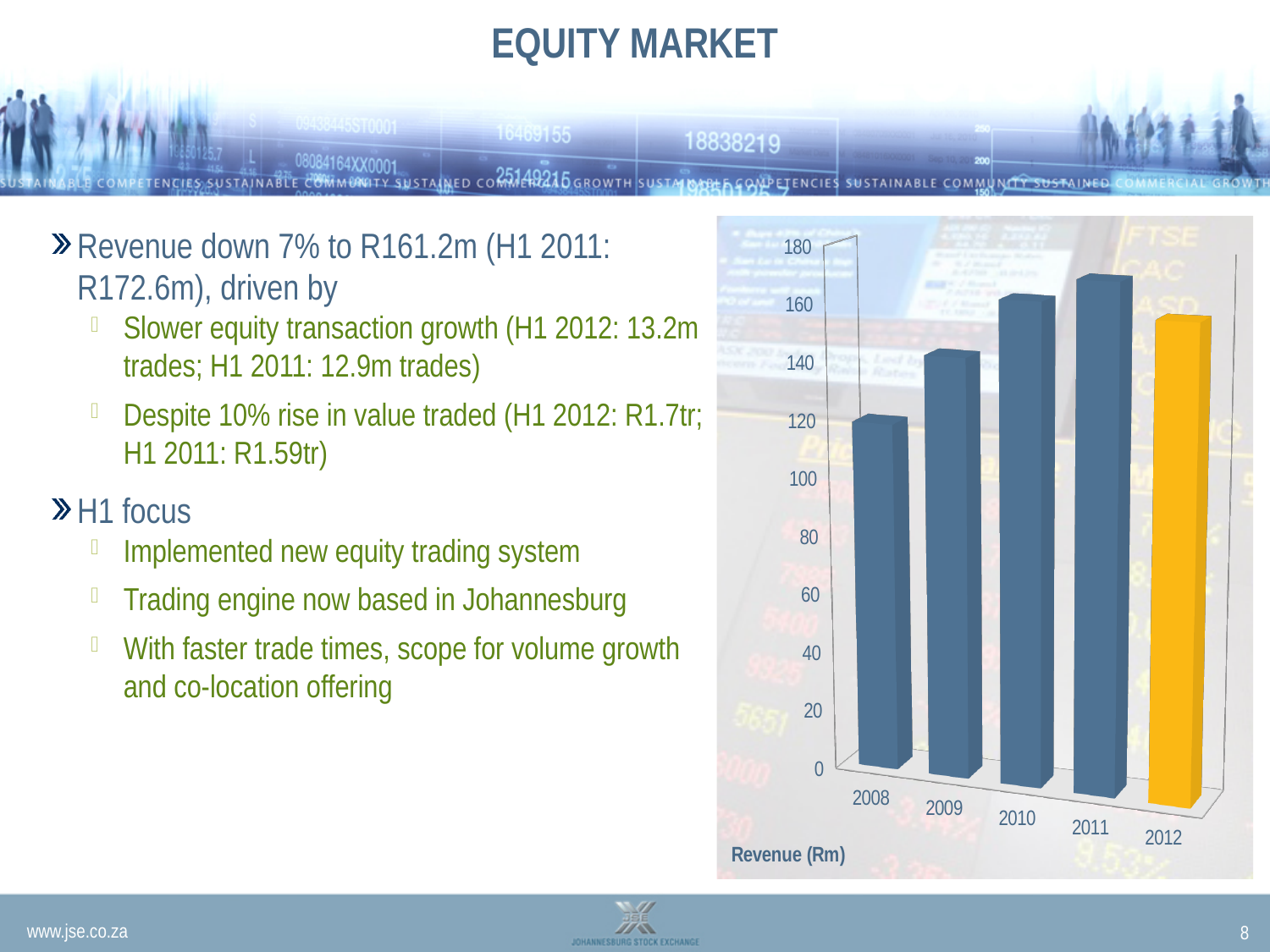
Is the value for 2009 greater or less than 120? greater Which year has the taller revenue bar, 2008 or 2009? 2009 Is the value for 2008 greater or less than 100? greater Which year has the lowest revenue bar in the chart? 2008 Do the revenue bars rise or fall from 2008 to 2011? Rise What label is shown beneath the chart describing the plotted values? Revenue (Rm) Which year's bar is coloured differently (orange) from the other blue bars? 2012 What kind of chart is shown on the slide? Bar chart Which year has the highest revenue bar in the chart? 2011 Is the value for 2010 greater or less than 140? greater How many years are shown on the x axis of the chart? 5 Is the revenue bar for 2011 taller than the bar for 2012? Yes